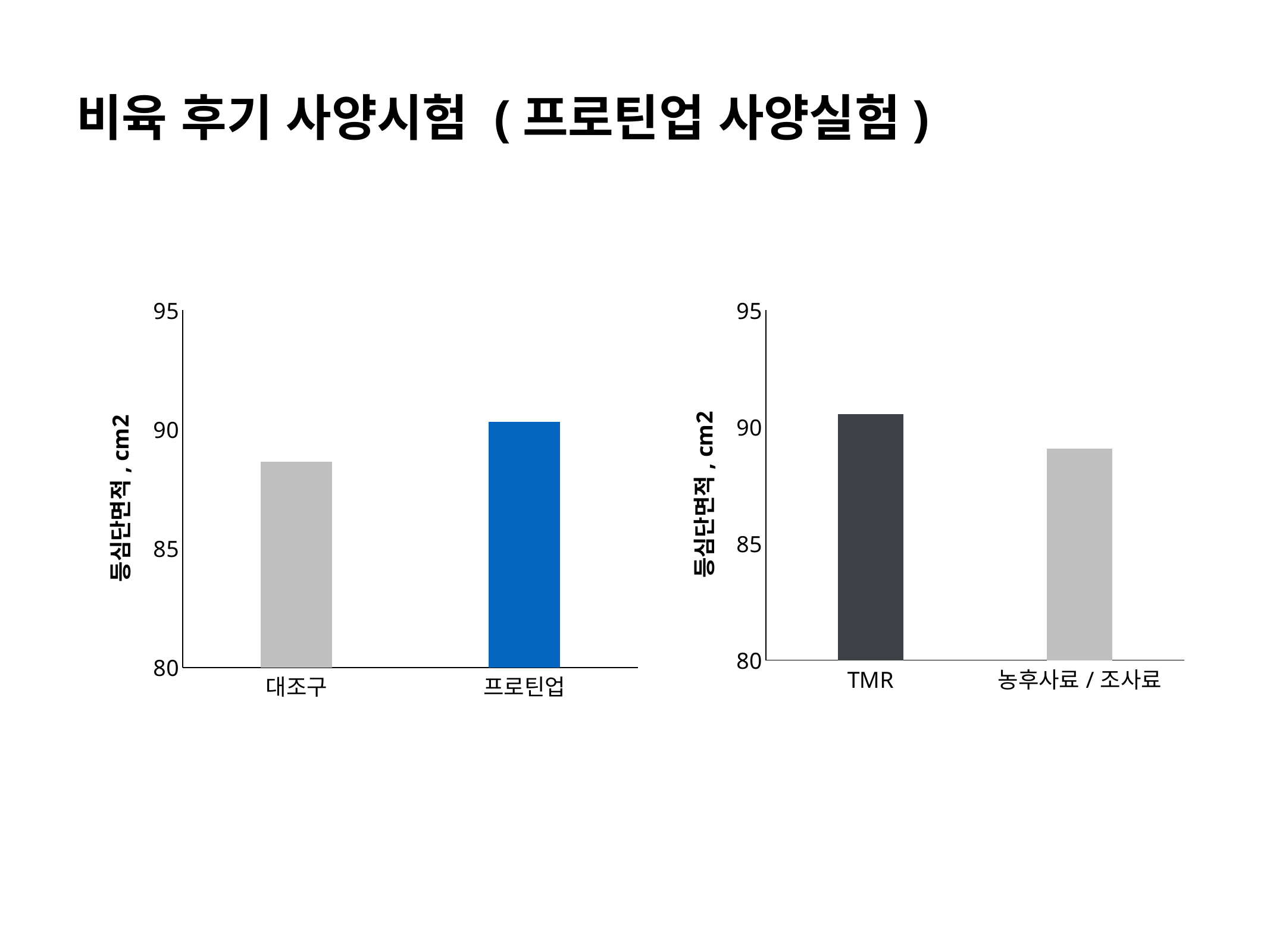
In the right chart, is the value for 농후사료 / 조사료 greater or less than 90? less In the right chart, is the value for TMR greater or less than 85? greater What is the y-axis title of the left chart? 등심단면적 , cm2 In the left chart, is the value for 대조구 greater or less than 90? less In the left chart, which category has the higher bar, 대조구 or 프로틴업? 프로틴업 What kind of chart is the right chart? bar chart In the left chart, what colour is the bar for 프로틴업? blue How many categories are shown in the left chart? 2 In the right chart, which category has the higher bar, TMR or 농후사료 / 조사료? TMR In the right chart, which category has the highest value? TMR In the left chart, which category has the lowest value? 대조구